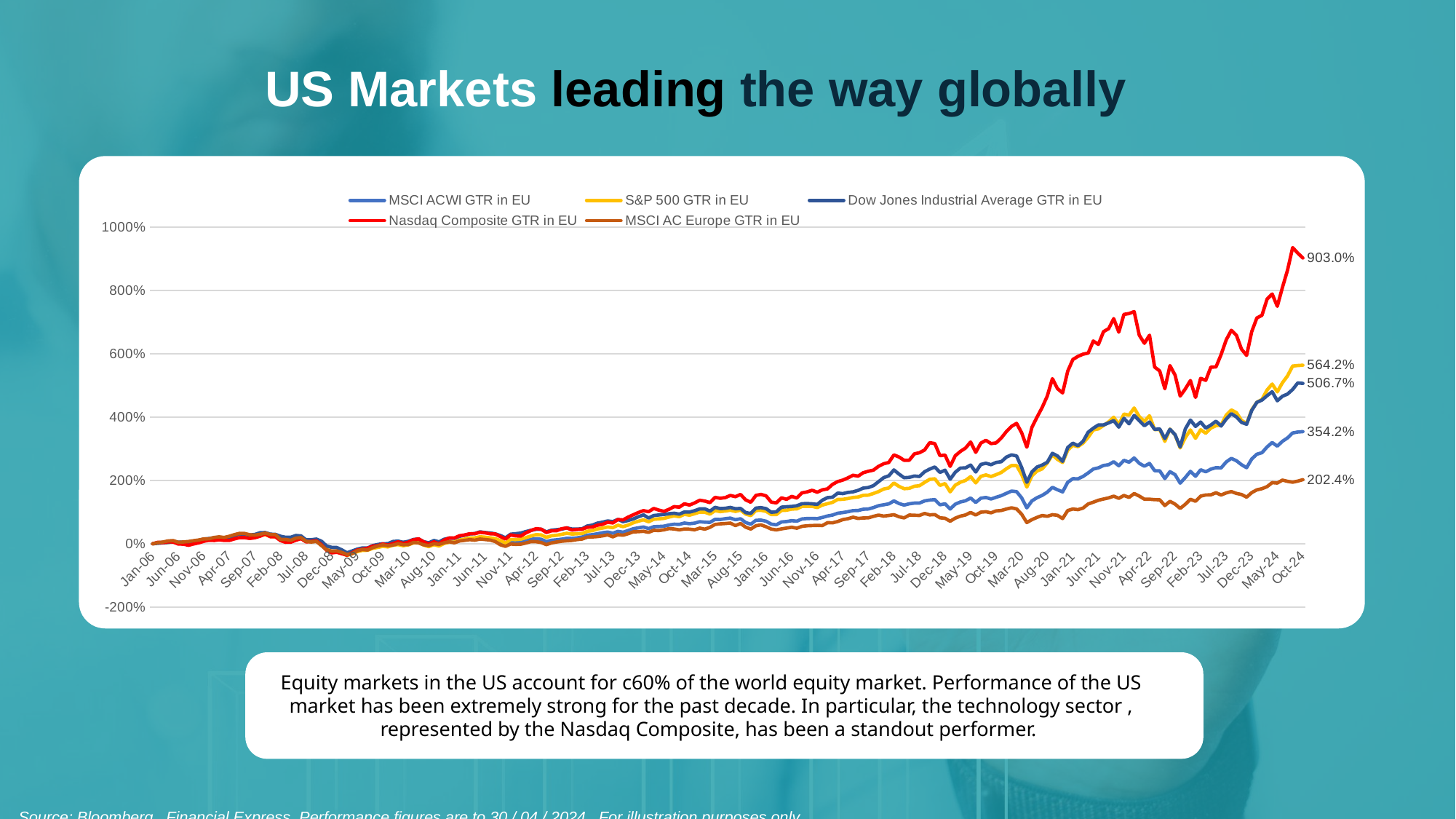
Which has a larger final value, MSCI ACWI GTR in EU or MSCI AC Europe GTR in EU? MSCI ACWI GTR in EU What is the final value shown for MSCI AC Europe GTR in EU? 202.4% What is the final value shown for S&P 500 GTR in EU? 564.2% What kind of chart is shown on the slide? line chart What colour is the line for Nasdaq Composite GTR in EU? red Which series has the lowest final value? MSCI AC Europe GTR in EU How many series does the legend list? 5 Which series has the highest final value? Nasdaq Composite GTR in EU What is the final value shown for Dow Jones Industrial Average GTR in EU? 506.7% What is the final value shown for Nasdaq Composite GTR in EU? 903.0% Do the series values generally rise or fall from Jan-06 to Oct-24? rise What is the difference between the final values of Nasdaq Composite GTR in EU and S&P 500 GTR in EU? 338.8%